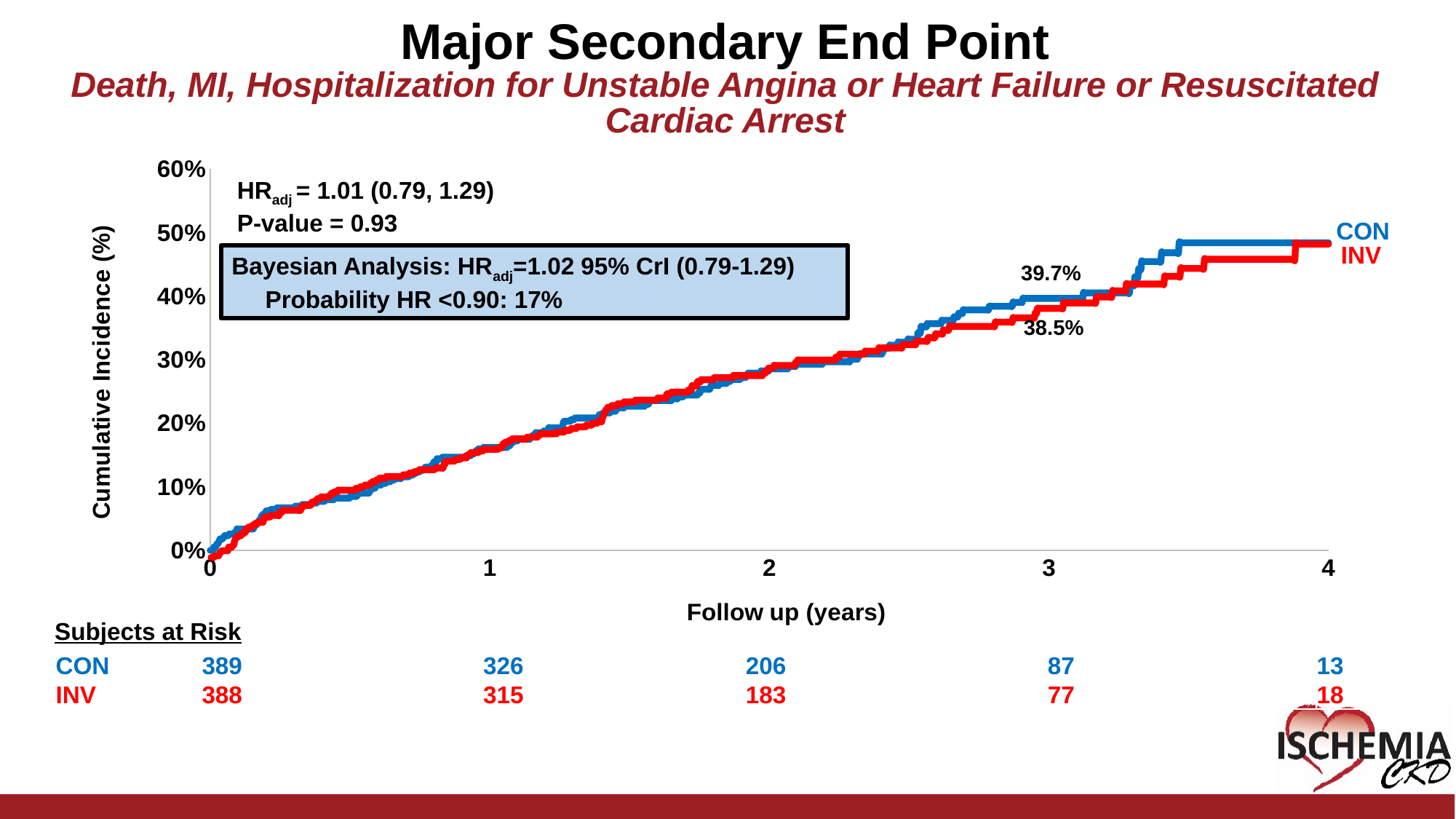
Which group has the higher labeled cumulative incidence value, CON or INV? CON Do the cumulative incidence curves rise or fall as follow-up time increases? Rise Is the cumulative incidence for the CON group at 4 years of follow up greater or less than 40%? greater Is the cumulative incidence for the INV group at 1 year of follow up greater or less than 20%? less What type of chart is shown on the slide? Line chart What cumulative incidence value is labeled on the chart for the CON group? 39.7% How many series (groups) are plotted on the chart? 2 How many subjects at risk are listed for the CON group at year 0? 389 How many subjects at risk are listed for the INV group at year 2? 183 What is the difference between the labeled cumulative incidence values for CON (39.7%) and INV (38.5%)? 1.2 percentage points What cumulative incidence value is labeled on the chart for the INV group? 38.5% What is the adjusted hazard ratio (HRadj) shown on the chart? 1.01 (0.79, 1.29)